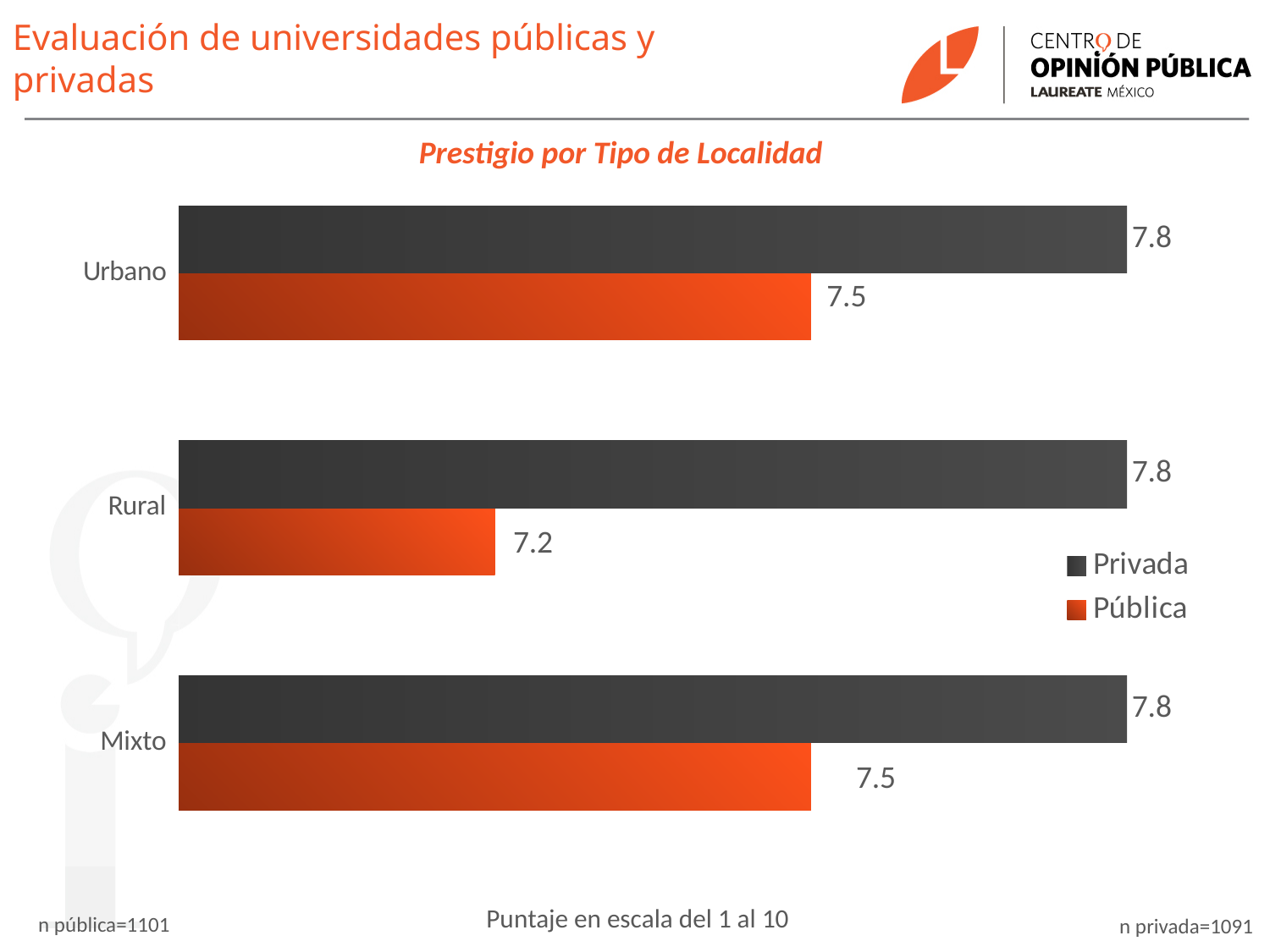
What kind of chart is shown on the slide? Bar chart What is the Pública value for Mixto? 7.5 Which is larger for Mixto, the Privada value or the Pública value? Privada What is the Pública value for Rural? 7.2 How many series does the legend list? 2 How many locality types are shown on the chart? 3 What is the Privada value for Rural? 7.8 What is the title of the chart? Prestigio por Tipo de Localidad What is the Privada value for Urbano? 7.8 Which locality type has the lowest Pública value? Rural What is the difference between the Privada and Pública values for Urbano? 0.3 What is the difference between the Privada and Pública values for Rural? 0.6